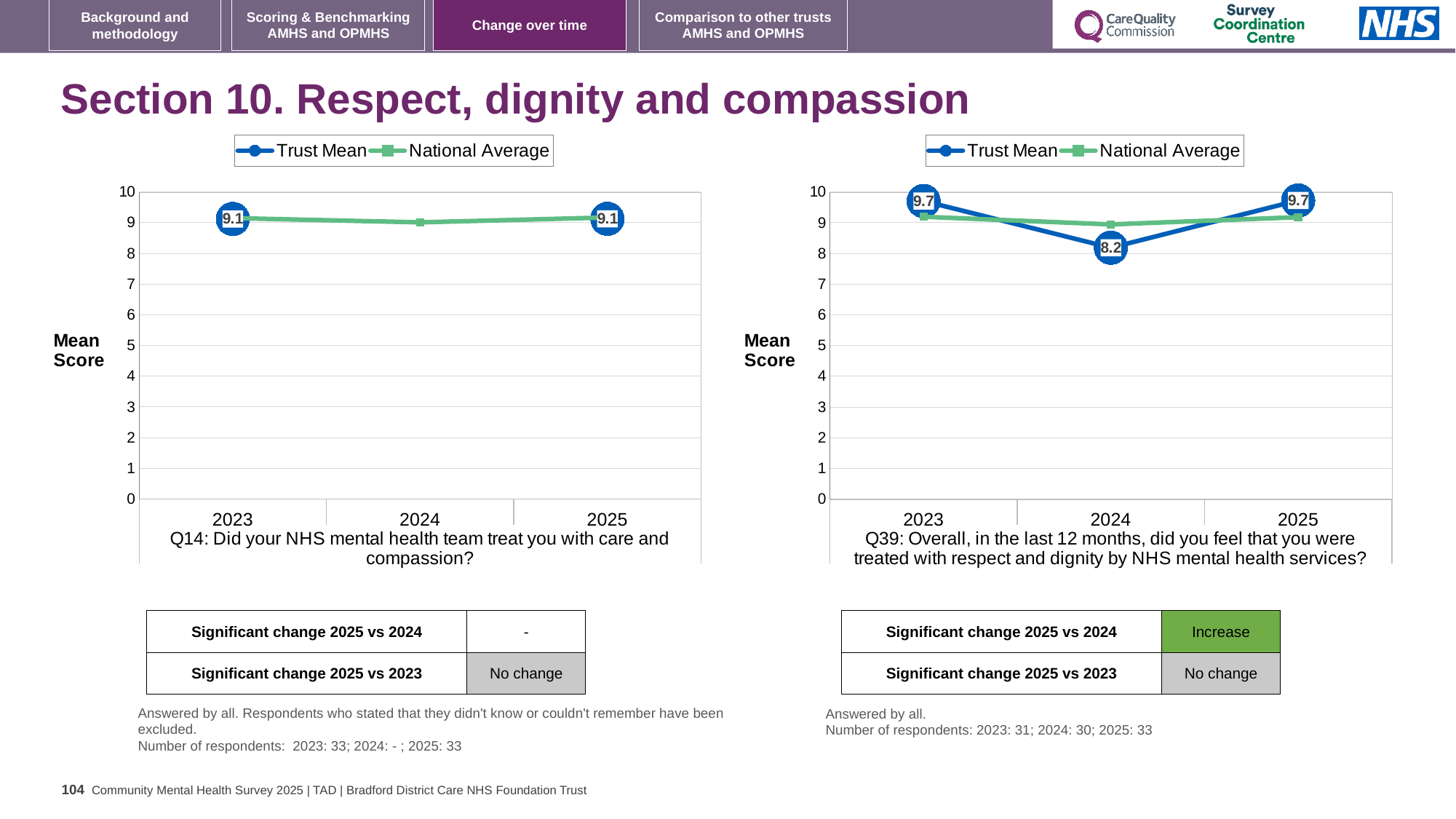
In the Q39 chart on the right, does the Trust Mean rise or fall from 2024 to 2025? rise In the Q14 chart on the left, is the National Average for 2024 greater or less than 5? greater In the Q14 chart on the left, what is the Trust Mean for 2023? 9.1 In the Q39 chart on the right, what is the Trust Mean for 2025? 9.7 How many series does the legend of the Q39 chart on the right list? 2 In the Q39 chart on the right, which year has the lowest Trust Mean? 2024 How many years are shown on the x axis of the Q14 chart on the left? 3 In the Q14 chart on the left, what is the Trust Mean for 2025? 9.1 In the Q39 chart on the right, what is the difference between the Trust Mean for 2023 and 2024? 1.5 What kind of chart is the Q39 chart on the right? line chart In the Q39 chart on the right, what is the Trust Mean for 2024? 8.2 In the Q39 chart on the right, is the Trust Mean for 2024 larger or smaller than the Trust Mean for 2025? smaller